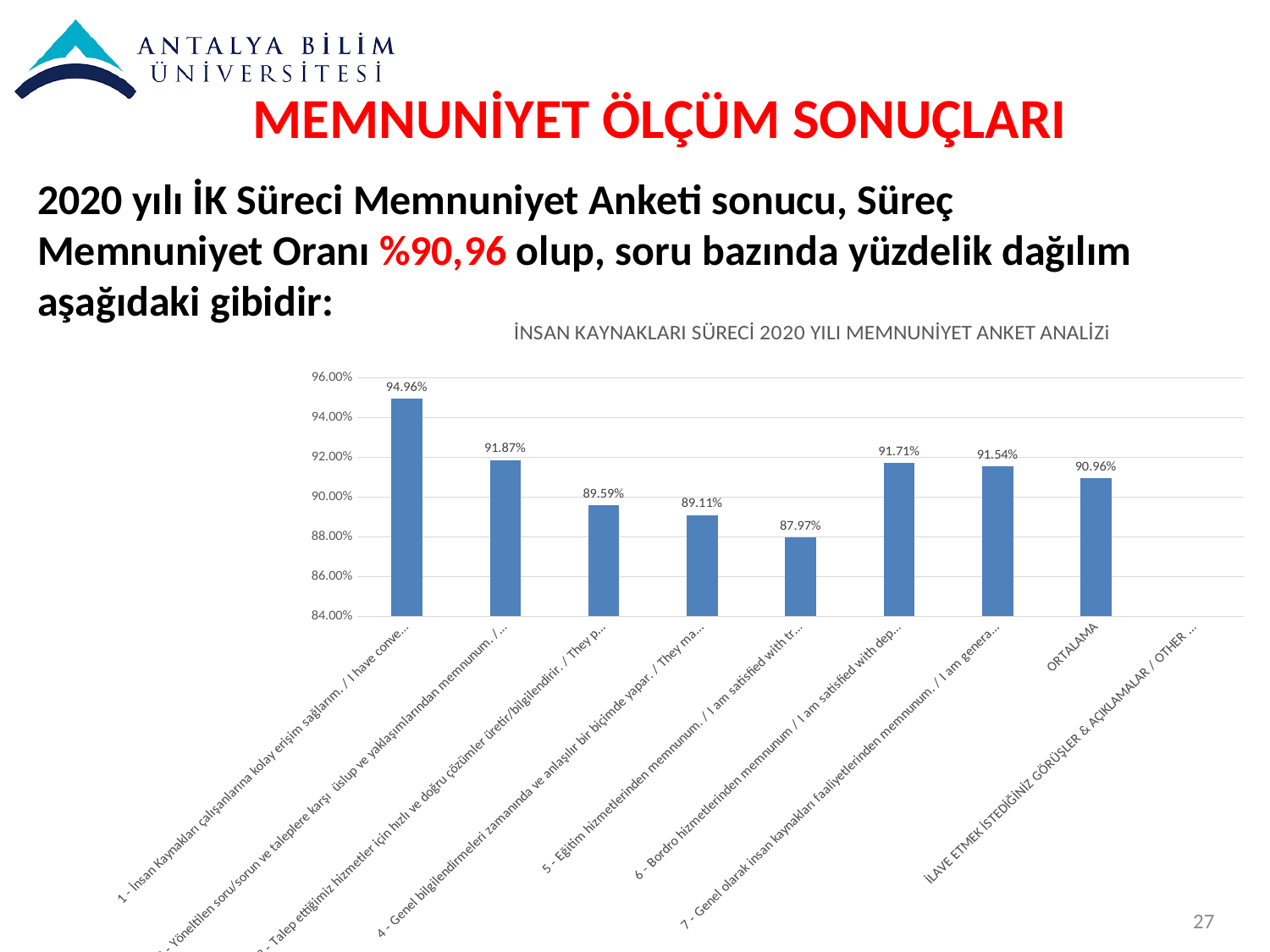
What is the value of the ORTALAMA bar? 90.96% Is the value for question 2 (Yöneltilen soru/sorun) greater or less than 90.00%? greater What type of chart is shown? Bar chart Which category has the lowest value? 5 - Eğitim hizmetlerinden memnunum What is the value for question 6 (Bordro hizmetlerinden memnunum)? 91.71% What is the value for question 1 (İnsan Kaynakları çalışanlarına kolay erişim sağlarım)? 94.96% Which is larger: the value for question 3 (Talep ettiğimiz hizmetler) or the value for question 4 (Genel bilgilendirmeleri)? Question 3 (89.59%) How many bars are plotted in the chart? 8 What is the difference between the value for question 1 (94.96%) and the value for question 5 (87.97%)? 6.99% Which category has the highest value? 1 - İnsan Kaynakları çalışanlarına kolay erişim sağlarım What is the title of the chart? İNSAN KAYNAKLARI SÜRECİ 2020 YILI MEMNUNİYET ANKET ANALİZİ What is the value for question 5 (Eğitim hizmetlerinden memnunum)? 87.97%